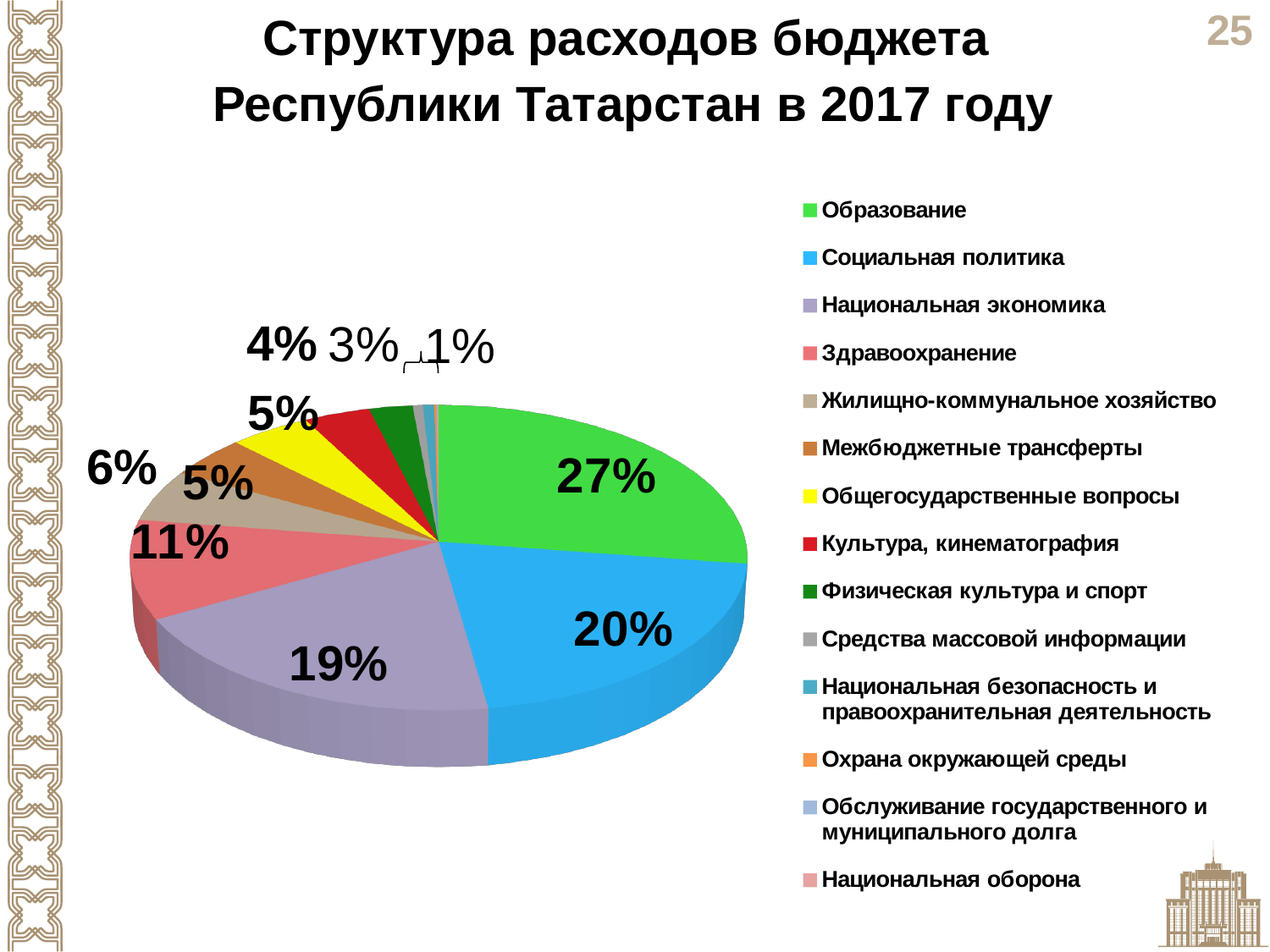
What type of chart is shown on the slide? Pie chart How many categories are listed in the chart legend? 14 What share of the budget expenditure does Образование (education) account for? 27% What percentage of expenditure goes to Здравоохранение? 11% What is the combined share of Образование, Социальная политика and Национальная экономика? 66% What share is shown for Жилищно-коммунальное хозяйство? 6% What colour represents Общегосударственные вопросы in the chart? Yellow What percentage is shown for Социальная политика? 20% Which expenditure category has the largest share of the pie? Образование Which is larger: the share for Национальная экономика or the share for Здравоохранение? Национальная экономика By how many percentage points does Образование exceed Социальная политика? 7 percentage points What share is labelled for Национальная экономика? 19%